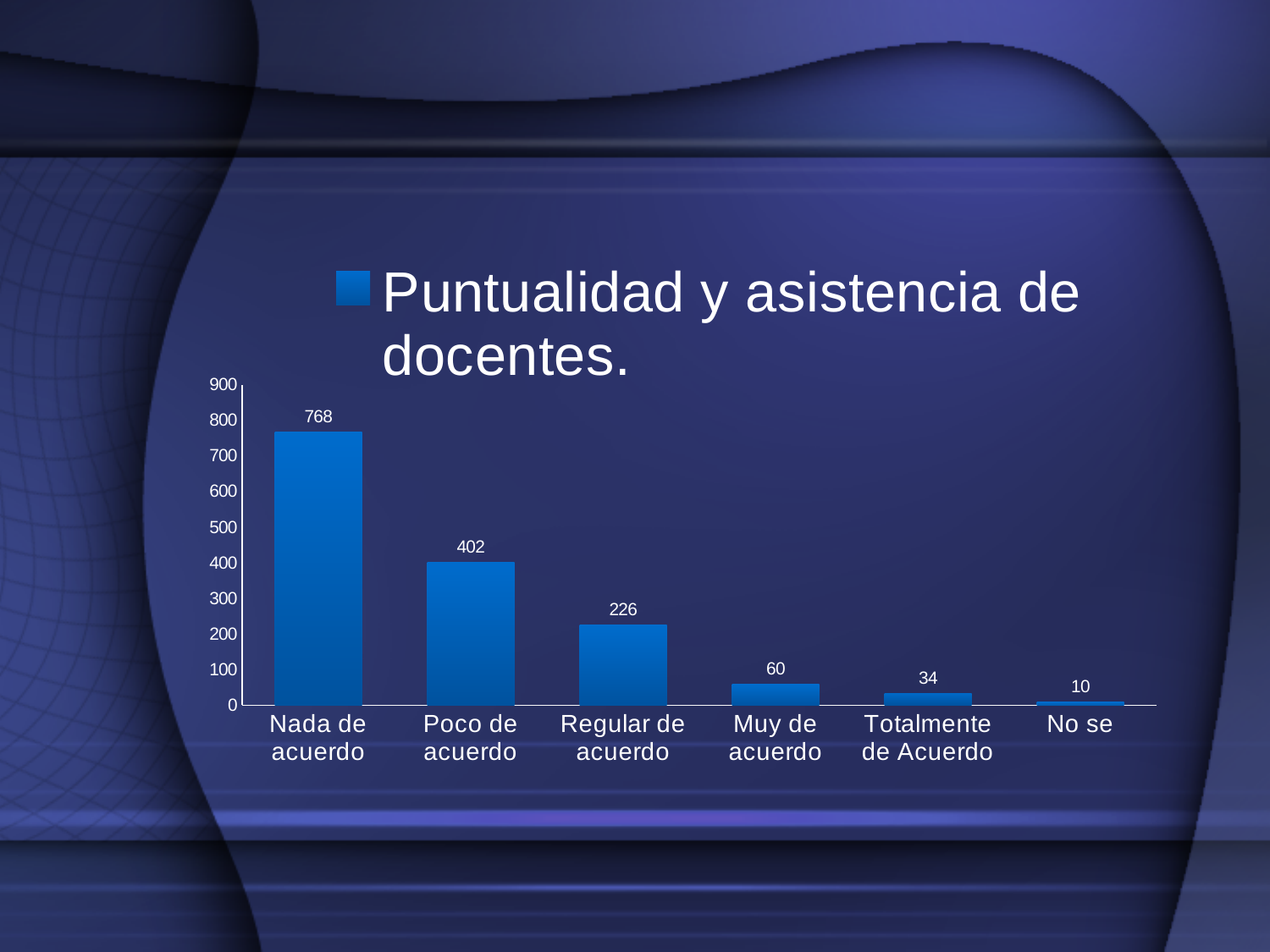
Which is larger, the value for "Poco de acuerdo" or the value for "Regular de acuerdo"? Poco de acuerdo What kind of chart is shown on the slide? bar chart How many categories are shown on the x axis? 6 Do the values rise or fall from left to right along the x axis? fall Which category has the highest value? Nada de acuerdo What is the value for "Nada de acuerdo"? 768 Which category has the lowest value? No se What is the value for "Regular de acuerdo"? 226 Is the value for "Regular de acuerdo" greater or less than 300? less What is the difference between the values for "Muy de acuerdo" and "Totalmente de Acuerdo"? 26 What is the difference between the values for "Nada de acuerdo" and "Poco de acuerdo"? 366 What is the value for "No se"? 10